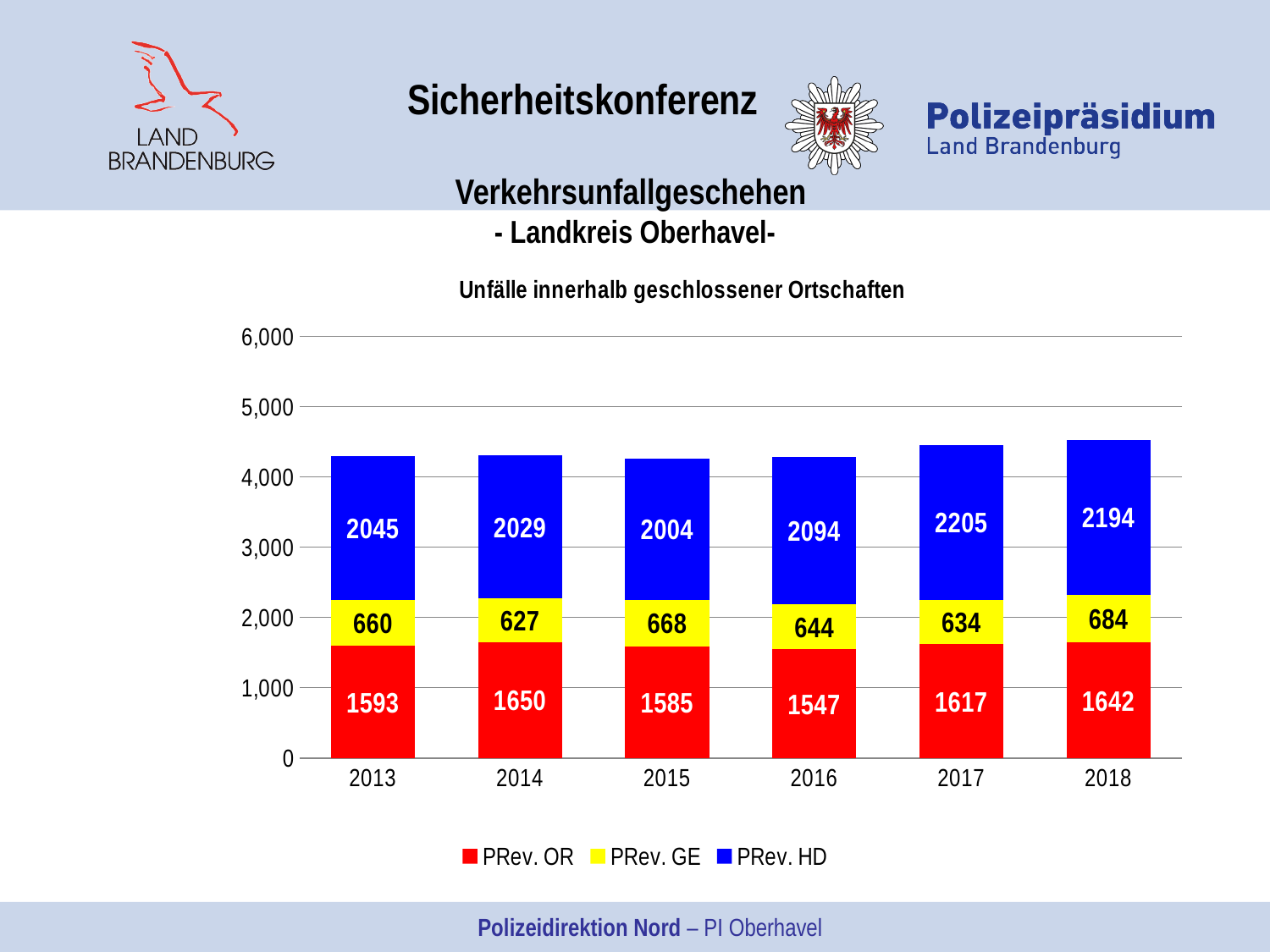
What is the total of the stacked bar for 2017? 4456 Which series is shown in yellow? PRev. GE How many years are shown on the x axis? 6 What is the difference between the PRev. GE values in 2018 and 2014? 57 What kind of chart is shown on the slide? Stacked bar chart What is the value for PRev. GE in 2018? 684 What is the value for PRev. HD in 2016? 2094 What is the value for PRev. OR in 2014? 1650 In which year is the PRev. HD value highest? 2017 In which year is the PRev. OR value lowest? 2016 How many series does the legend list? 3 Which is larger, the PRev. HD value in 2013 or in 2015? 2013